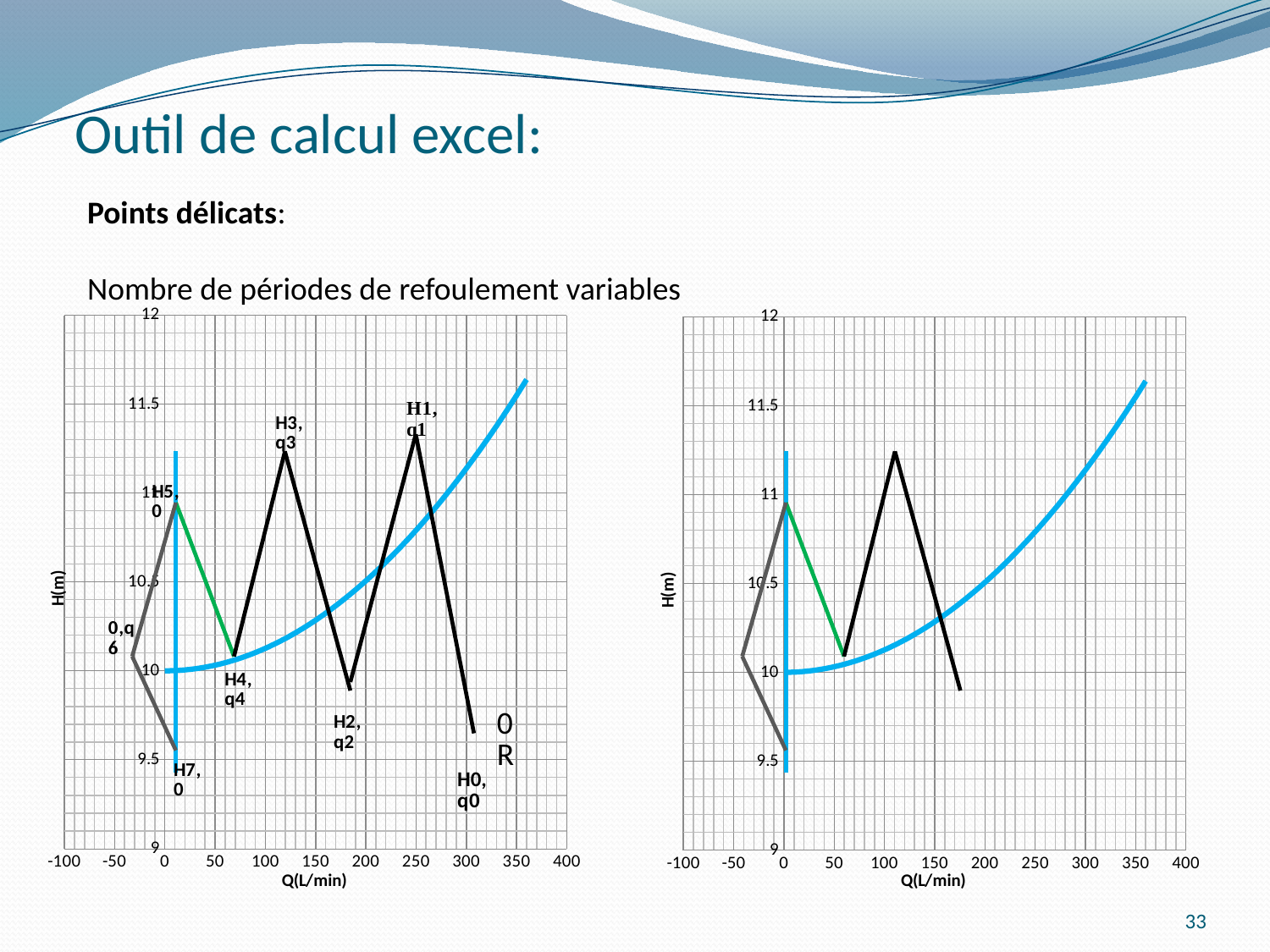
On the left chart, is the H value of the point labelled H0,q0 greater or less than 10? less On the left chart, which point has the larger Q value, H0,q0 or H4,q4? H0,q0 What kind of chart is the left chart on the slide? line chart On the left chart, is the Q value of the point labelled 0,q6 greater or less than 0? less On the left chart, is the H value of the point labelled H2,q2 greater or less than 10.5? less On the left chart, which point has the higher H value, H1,q1 or H4,q4? H1,q1 What is the title of the y axis on the right chart? H(m) What is the title of the x axis on the left chart? Q(L/min)